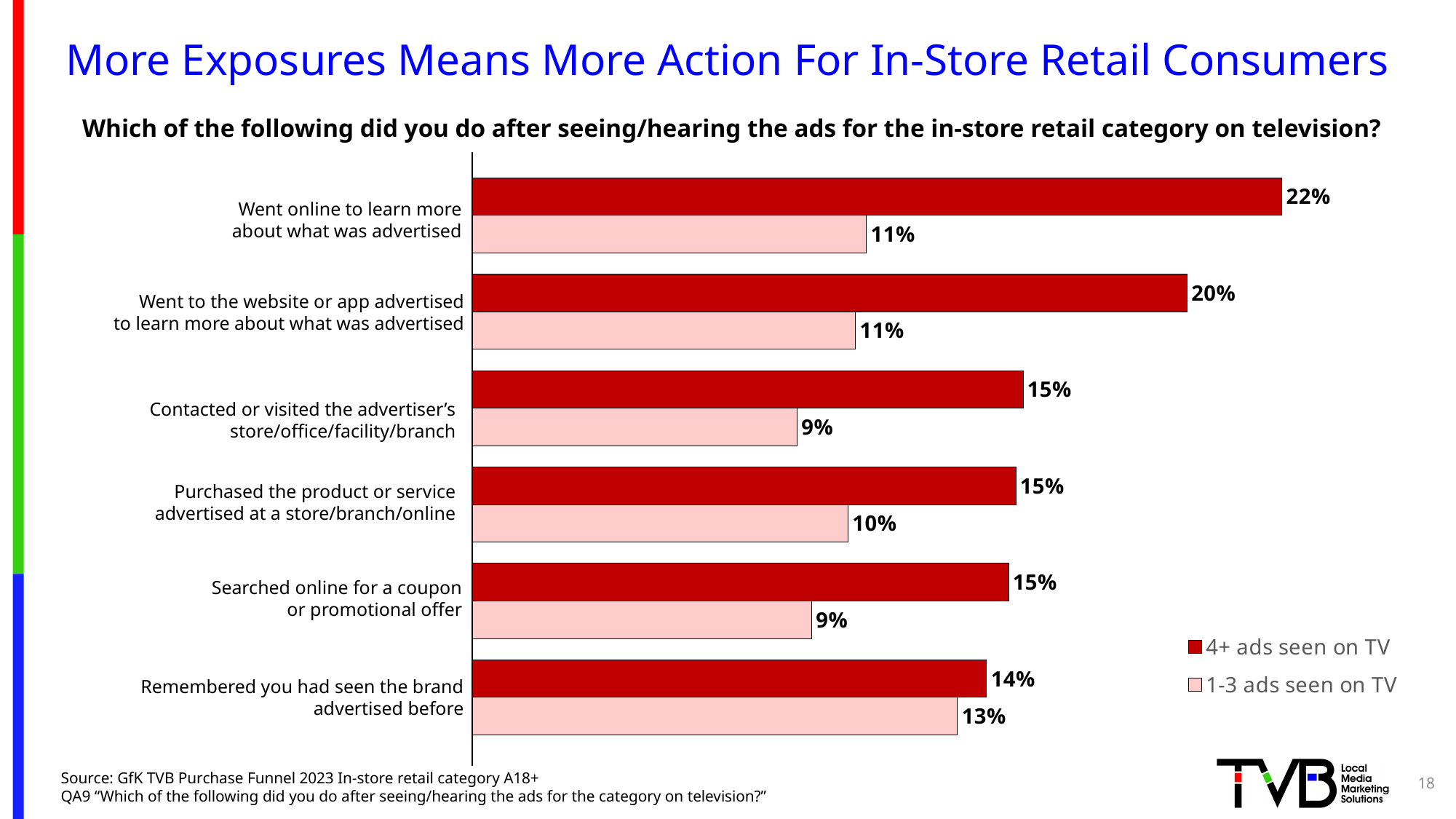
Which series is shown in dark red in the chart? 4+ ads seen on TV How many actions (categories) are shown in the chart? 6 What is the value for 'Searched online for a coupon or promotional offer' among those who saw 1-3 ads on TV? 9% Which action has the lowest value for the 4+ ads seen on TV series? Remembered you had seen the brand advertised before For 'Purchased the product or service advertised at a store/branch/online', which group has the larger value: 4+ ads seen on TV or 1-3 ads seen on TV? 4+ ads seen on TV What percentage of those who saw 1-3 ads on TV remembered they had seen the brand advertised before? 13% How many series does the legend list? 2 What type of chart is shown on the slide? Bar chart What percentage of those who saw 4+ ads on TV went online to learn more about what was advertised? 22% Which action has the highest value for the 4+ ads seen on TV series? Went online to learn more about what was advertised What is the difference between the 4+ ads and 1-3 ads values for 'Remembered you had seen the brand advertised before'? 1 percentage point What is the difference between the 4+ ads and 1-3 ads values for 'Went online to learn more about what was advertised'? 11 percentage points